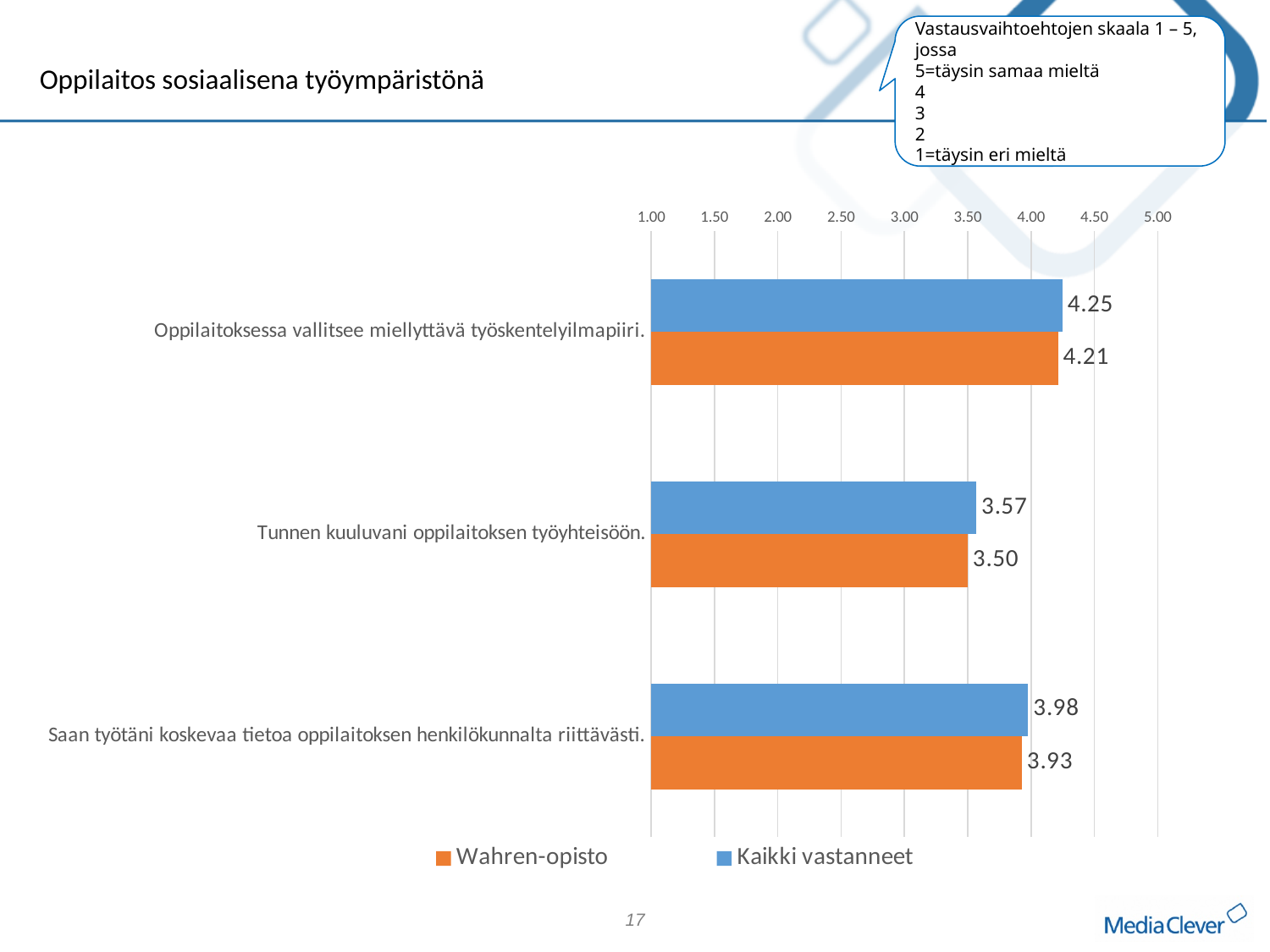
What is the difference between Kaikki vastanneet and Wahren-opisto for "Tunnen kuuluvani oppilaitoksen työyhteisöön."? 0.07 Is the Wahren-opisto value for "Oppilaitoksessa vallitsee miellyttävä työskentelyilmapiiri." greater or less than 4.00? greater What kind of chart is shown on the slide? bar chart Which statement has the lowest value for Wahren-opisto? Tunnen kuuluvani oppilaitoksen työyhteisöön. What is the value for Wahren-opisto for "Oppilaitoksessa vallitsee miellyttävä työskentelyilmapiiri."? 4.21 Which statement has the highest value for Kaikki vastanneet? Oppilaitoksessa vallitsee miellyttävä työskentelyilmapiiri. What is the value for Kaikki vastanneet for "Tunnen kuuluvani oppilaitoksen työyhteisöön."? 3.57 Which colour represents Wahren-opisto in the chart? orange What is the value for Wahren-opisto for "Saan työtäni koskevaa tietoa oppilaitoksen henkilökunnalta riittävästi."? 3.93 For "Saan työtäni koskevaa tietoa oppilaitoksen henkilökunnalta riittävästi.", which series has the larger value, Wahren-opisto or Kaikki vastanneet? Kaikki vastanneet How many categories (statements) are plotted in the chart? 3 How many series does the legend list? 2